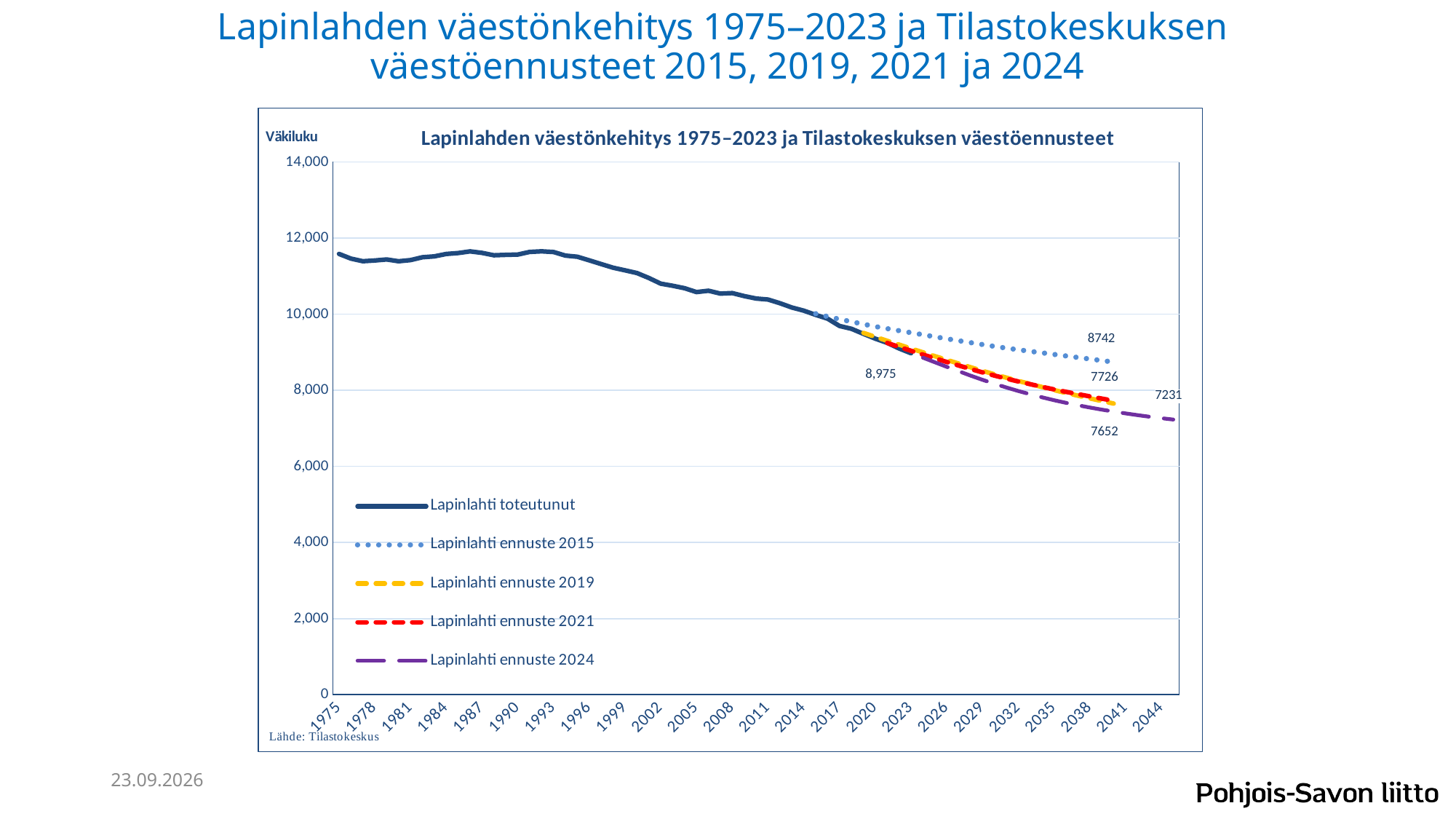
What is the final labelled value of the 'Lapinlahti ennuste 2015' series? 8742 What source is cited below the chart? Tilastokeskus What is the final labelled value of the 'Lapinlahti ennuste 2024' series? 7231 What is the difference between the final labelled values of 'Lapinlahti ennuste 2015' (8742) and 'Lapinlahti ennuste 2024' (7231)? 1511 How many series does the legend list? 5 What is the labelled value at the end of the 'Lapinlahti toteutunut' series? 8,975 Does the 'Lapinlahti toteutunut' series rise or fall between 1993 and 2023? fall What kind of chart is shown on the slide? line chart Is the value of 'Lapinlahti toteutunut' in 1975 greater or less than 11,000? greater Is the value of 'Lapinlahti toteutunut' in 2005 greater or less than 10,000? greater Which forecast series ends at a higher value, 'Lapinlahti ennuste 2015' or 'Lapinlahti ennuste 2024'? Lapinlahti ennuste 2015 What label is shown on the vertical axis of the chart? Väkiluku